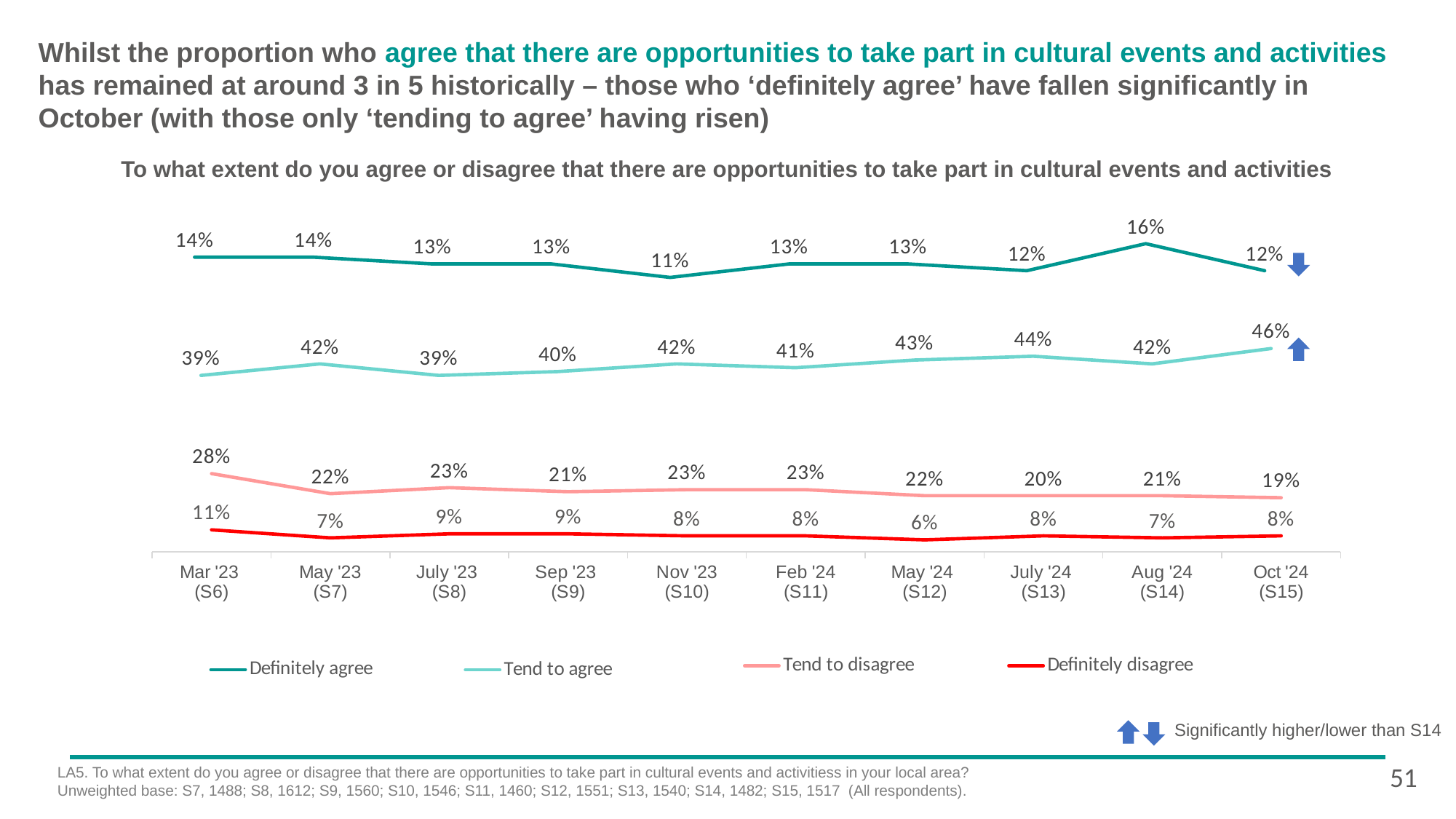
What is the value for 'Definitely agree' in Aug '24 (S14)? 16% How many series does the legend list? 4 What is the value for 'Tend to disagree' in Mar '23 (S6)? 28% What kind of chart is shown on the slide? Line chart In which wave is 'Tend to agree' highest? Oct '24 (S15) What is the value for 'Tend to agree' in Oct '24 (S15)? 46% What is the difference between 'Tend to agree' in Oct '24 (S15) and Aug '24 (S14)? 4 percentage points In which wave is 'Definitely disagree' lowest? May '24 (S12) Which is larger in Nov '23 (S10): 'Tend to disagree' or 'Definitely agree'? Tend to disagree How many waves (time points) are shown on the x axis? 10 What is the value for 'Definitely disagree' in May '24 (S12)? 6% Did 'Definitely agree' rise or fall between Aug '24 (S14) and Oct '24 (S15)? Fall